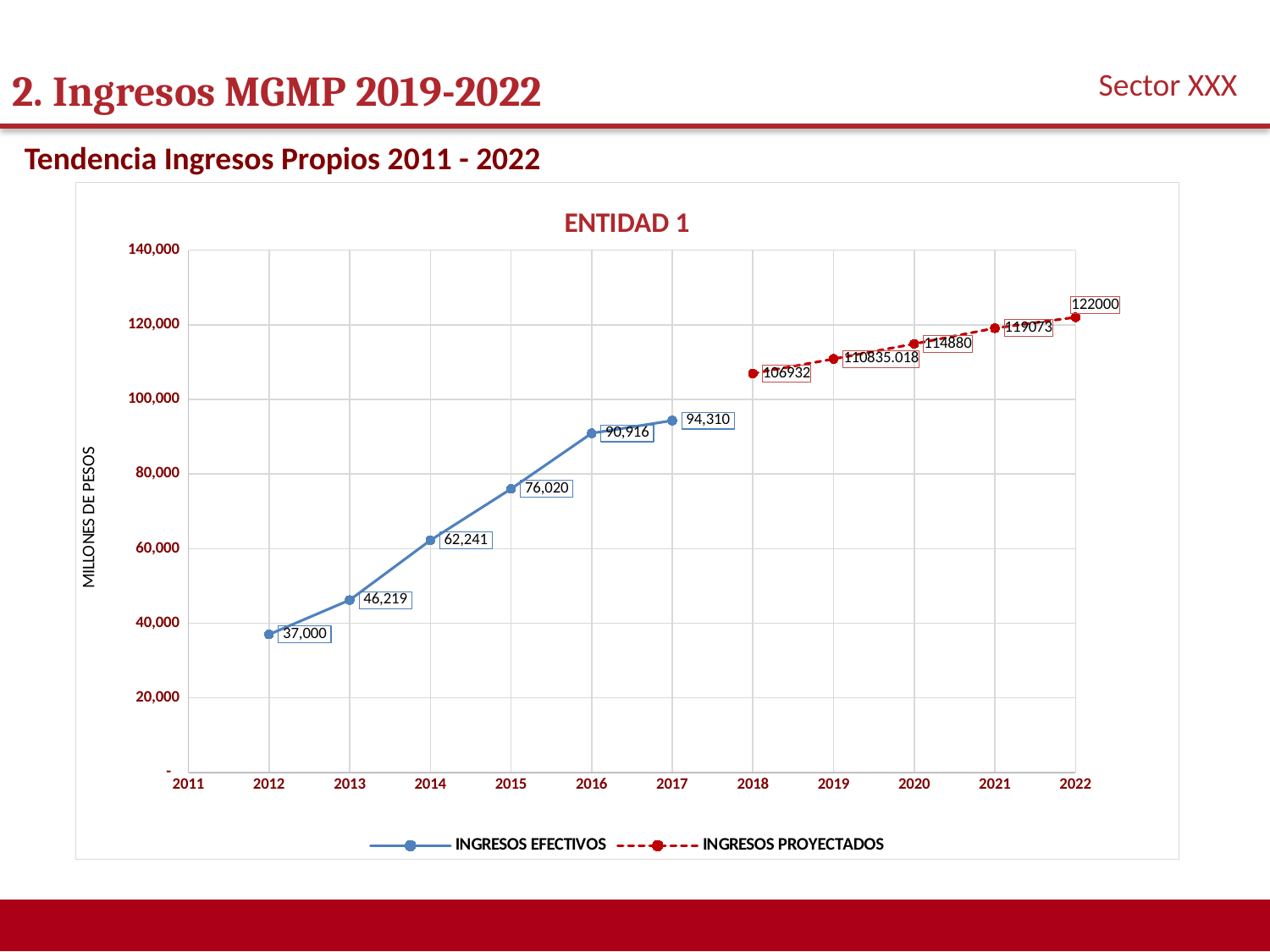
How many series does the legend list? 2 What is the value for INGRESOS PROYECTADOS in 2022? 122000 Which is larger, the value for 2014 or the value for 2013? 2014 What is the value for INGRESOS EFECTIVOS in 2015? 76,020 What is the difference between the INGRESOS EFECTIVOS values for 2017 and 2016? 3,394 Is the value for INGRESOS PROYECTADOS in 2021 greater or less than 100,000? greater Do the values rise or fall from 2012 to 2022? rise Which year has the lowest value for INGRESOS PROYECTADOS? 2018 What is the value for INGRESOS PROYECTADOS in 2020? 114880 Which year has the highest value for INGRESOS EFECTIVOS? 2017 What is the value for INGRESOS EFECTIVOS in 2012? 37,000 What kind of chart is shown? line chart